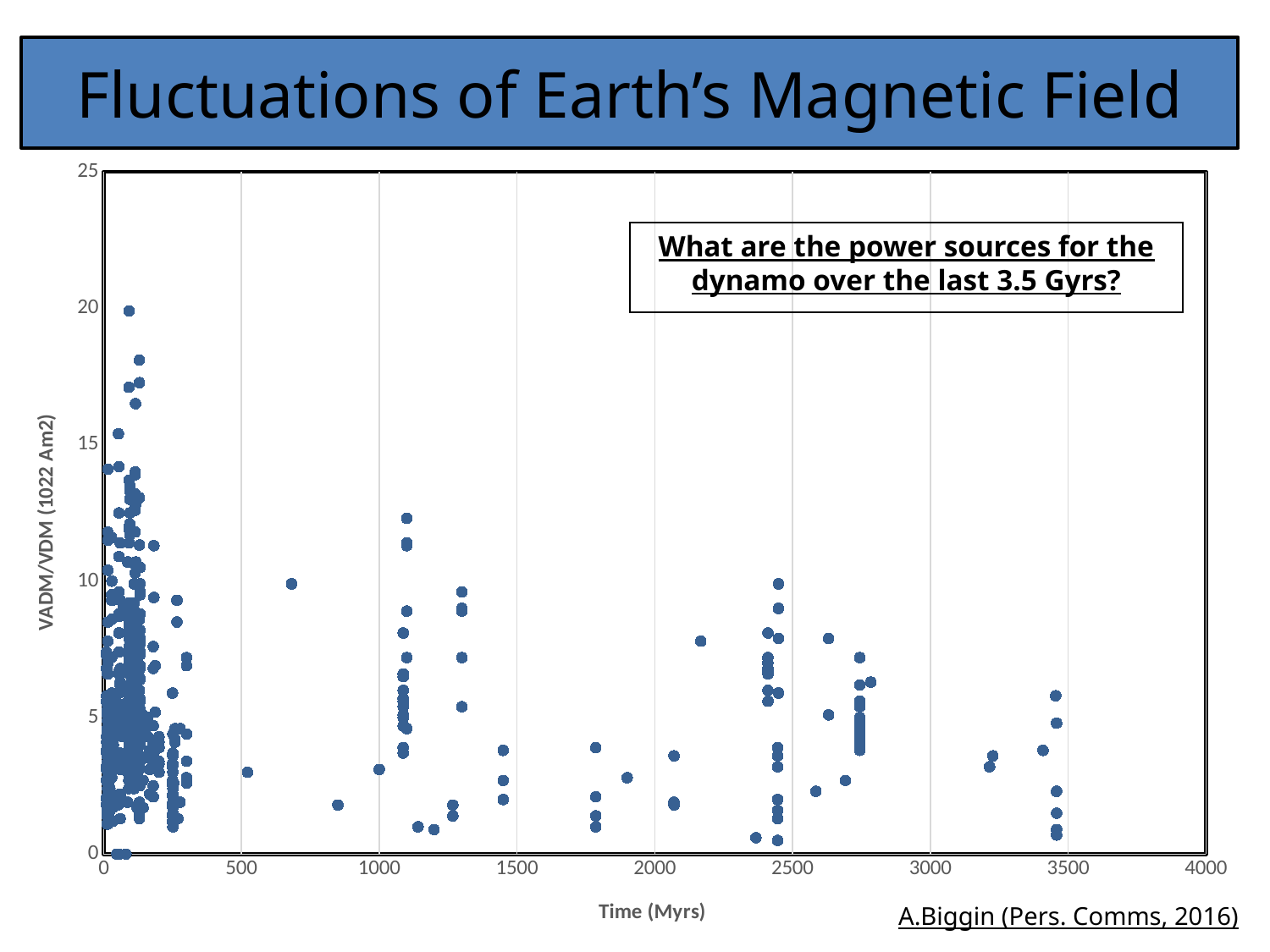
Is the highest point on the chart located before or after 500 Myrs on the time axis? before Do the highest plotted values generally rise or fall as time increases along the x axis? fall Is the value plotted near 2150 Myrs greater or less than 5? greater Is the highest value plotted near 1100 Myrs greater or less than 10? greater What is the label of the y axis? VADM/VDM (1022 Am2) What kind of chart is shown on the slide? scatter chart What is the label of the x axis? Time (Myrs) Is the highest value plotted near 2450 Myrs greater or less than 15? less Which group of points has the higher maximum value: those near 1100 Myrs or those near 3450 Myrs? near 1100 Myrs